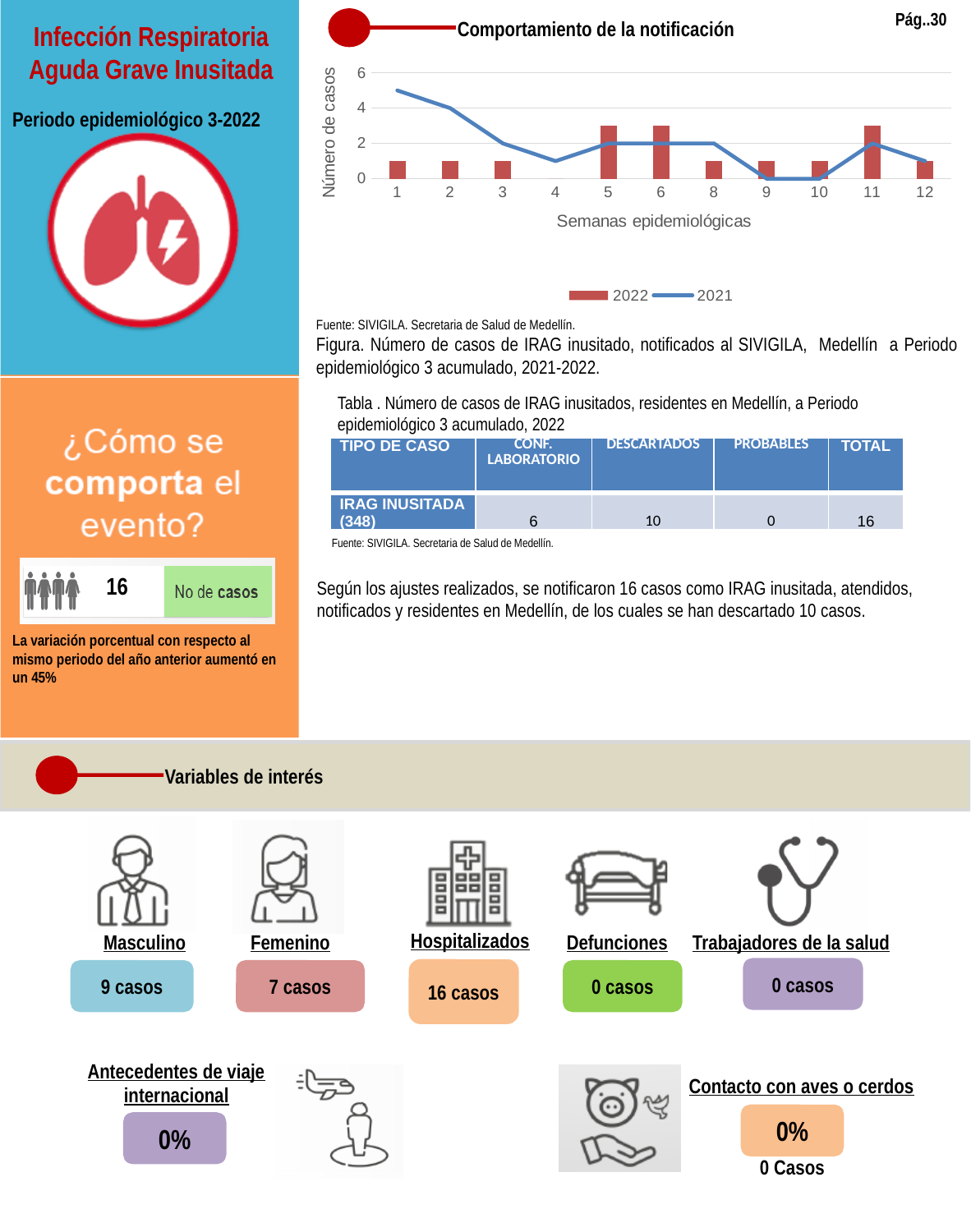
In the 'Comportamiento de la notificación' chart, does the 2021 line generally rise or fall from week 1 to week 12? fall In the 'Comportamiento de la notificación' chart, which is larger for week 1: the 2022 value or the 2021 value? 2021 In the 'Comportamiento de la notificación' chart, what is the 2021 value for week 9? 0 What kind of chart is shown under 'Comportamiento de la notificación'? A combined bar and line chart In the 'Comportamiento de la notificación' chart, which is larger for week 5: the 2022 value or the 2021 value? 2022 In the 'Comportamiento de la notificación' chart, is the 2022 value for week 5 greater or less than 2? greater In the 'Comportamiento de la notificación' chart, is the 2021 value for week 1 greater or less than 4? greater In the 'Comportamiento de la notificación' chart, in which week is the 2021 value highest? Week 1 How many series does the legend of the 'Comportamiento de la notificación' chart list? 2 In the 'Comportamiento de la notificación' chart, is the 2022 value for week 1 greater or less than 2? less Which series in the 'Comportamiento de la notificación' chart is drawn as bars? 2022 How many epidemiological weeks are shown on the x axis of the 'Comportamiento de la notificación' chart? 11